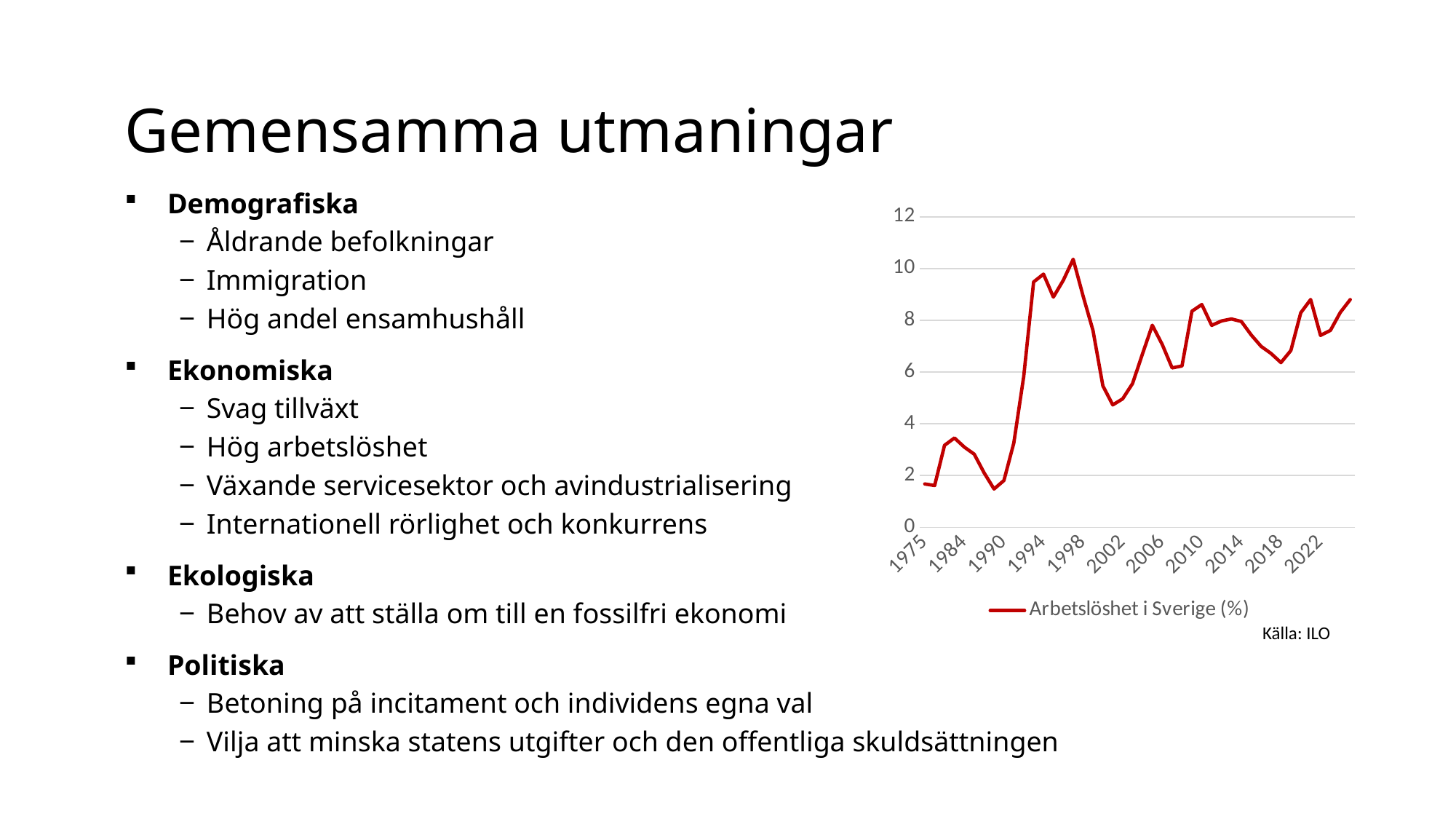
What source is cited below the chart? Källa: ILO Is the value for 2002 greater or less than 6? less Is the value for 1975 greater or less than 2? less How many series does the chart's legend list? 1 What kind of chart is shown on the slide? line chart Does the line rise or fall between 1998 and 2002? fall Is the value for 2022 greater or less than 6? greater What is the name of the series shown in the chart's legend? Arbetslöshet i Sverige (%) Does the line rise or fall between 1990 and 1994? rise